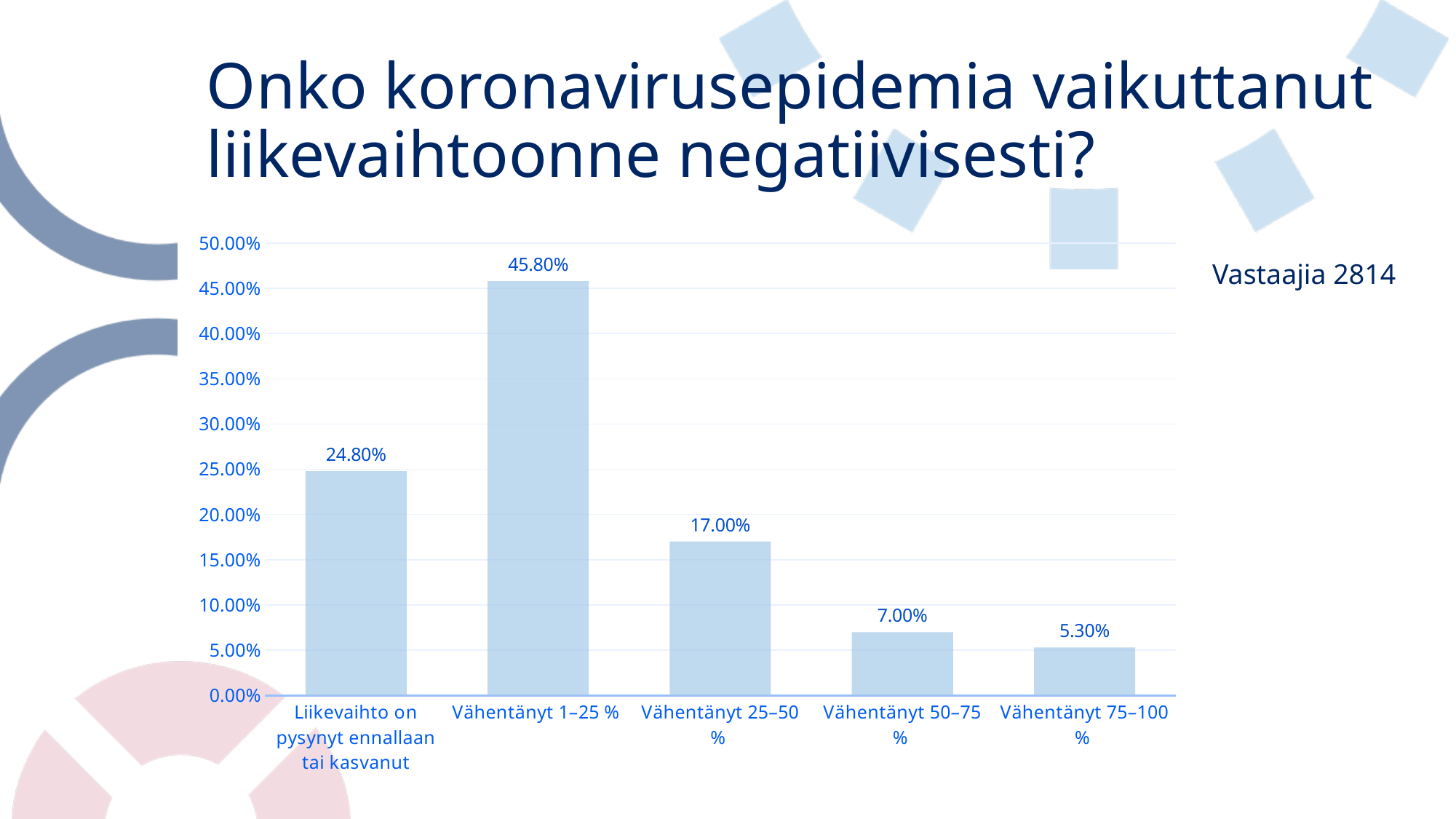
How many categories are shown on the x axis? 5 What is the value for "Vähentänyt 75–100 %"? 5.30% What is the value for "Liikevaihto on pysynyt ennallaan tai kasvanut"? 24.80% What is the value for "Vähentänyt 1–25 %"? 45.80% What is the difference between the values for "Vähentänyt 1–25 %" and "Vähentänyt 25–50 %"? 28.80% Is the value for "Vähentänyt 25–50 %" greater or less than 20.00%? less What kind of chart is shown on the slide? bar chart Which category has the lowest value? Vähentänyt 75–100 % How many respondents (Vastaajia) does the slide report? 2814 Which category has the highest value? Vähentänyt 1–25 % Which is larger, the value for "Liikevaihto on pysynyt ennallaan tai kasvanut" or the value for "Vähentänyt 25–50 %"? Liikevaihto on pysynyt ennallaan tai kasvanut What is the difference between the values for "Vähentänyt 50–75 %" and "Vähentänyt 75–100 %"? 1.70%